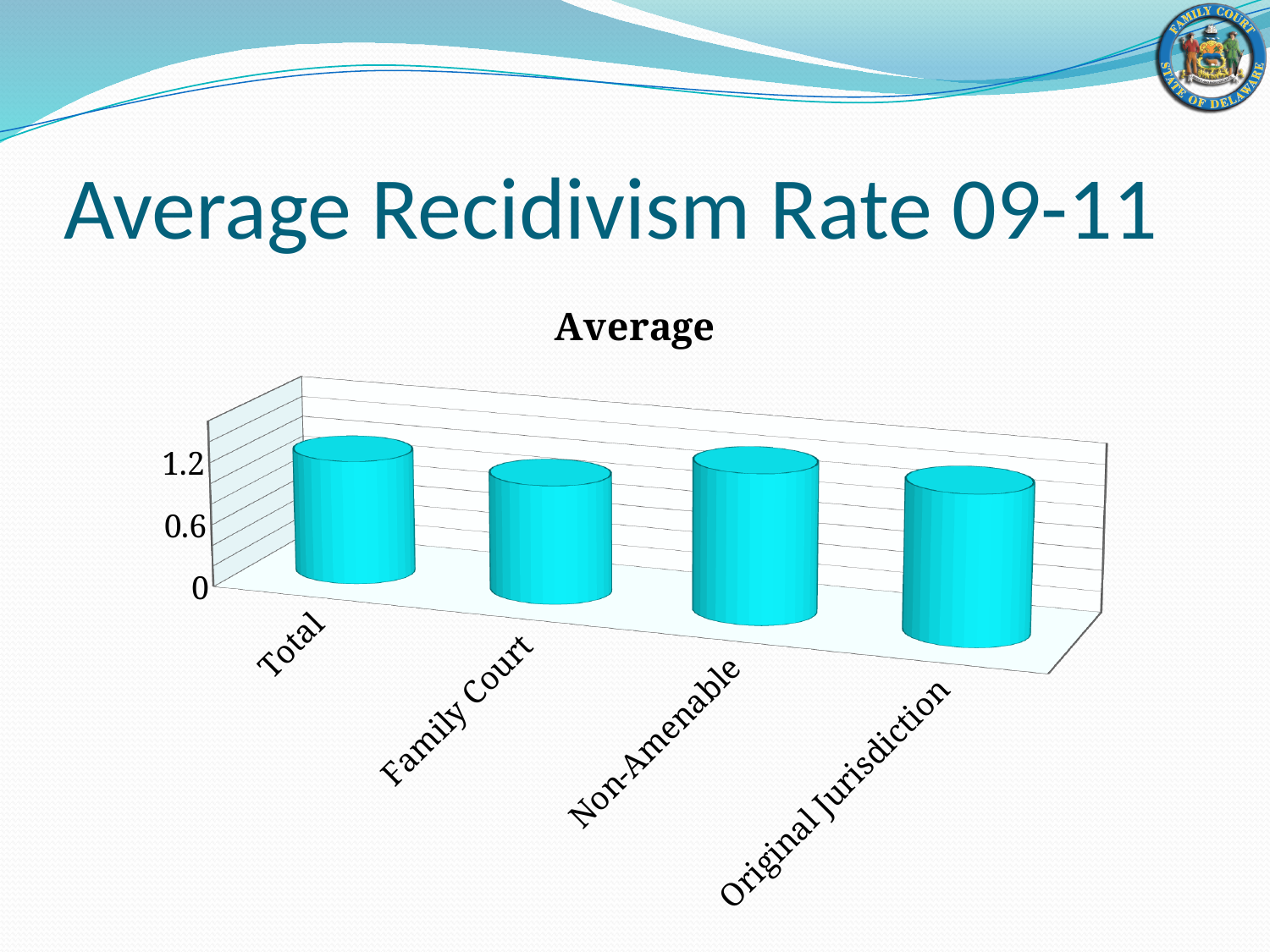
How many categories are plotted on the chart? 4 Is the value for Family Court greater or less than 0.6? greater What kind of chart is shown on the slide? bar chart What is the title of the chart? Average Is the value for Total greater or less than 0.6? greater Is the value for Original Jurisdiction greater or less than 0.6? greater What is the highest tick value shown on the vertical axis? 1.2 What is the title of the slide? Average Recidivism Rate 09-11